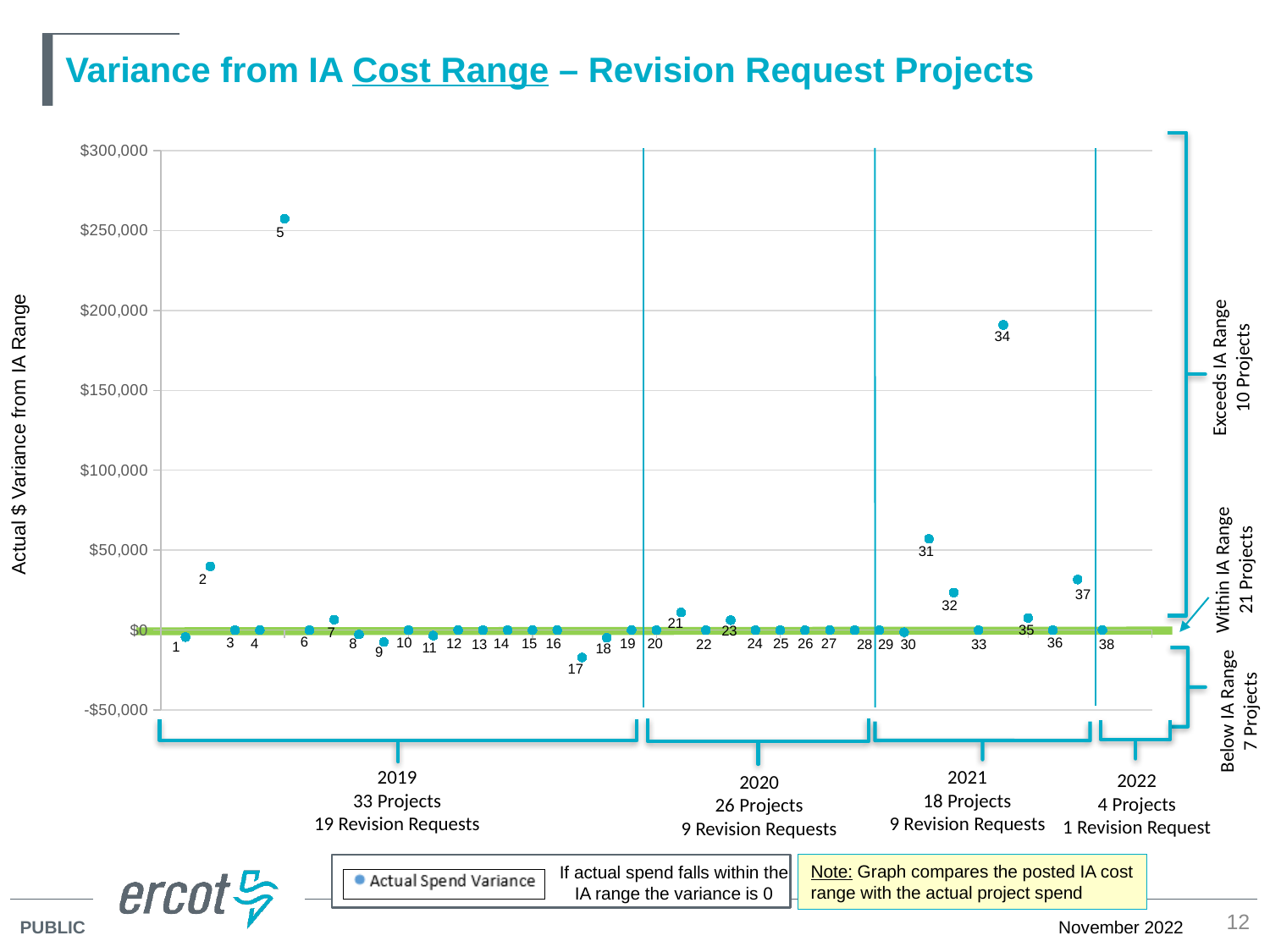
Is the value for project 34 greater or less than $200,000? less Which numbered project has the lowest (most negative) actual $ variance from IA range? 17 What kind of chart is shown on the slide? Scatter chart How many series does the legend list? 1 Is the value for project 31 greater or less than $50,000? greater What is the label on the vertical axis of the chart? Actual $ Variance from IA Range Which has the larger variance, project 31 or project 37? Project 31 Is the value for project 5 greater or less than $250,000? greater How many numbered project points are plotted on the chart? 38 Which has the larger variance, project 5 or project 34? Project 5 Which numbered project has the highest actual $ variance from IA range? 5